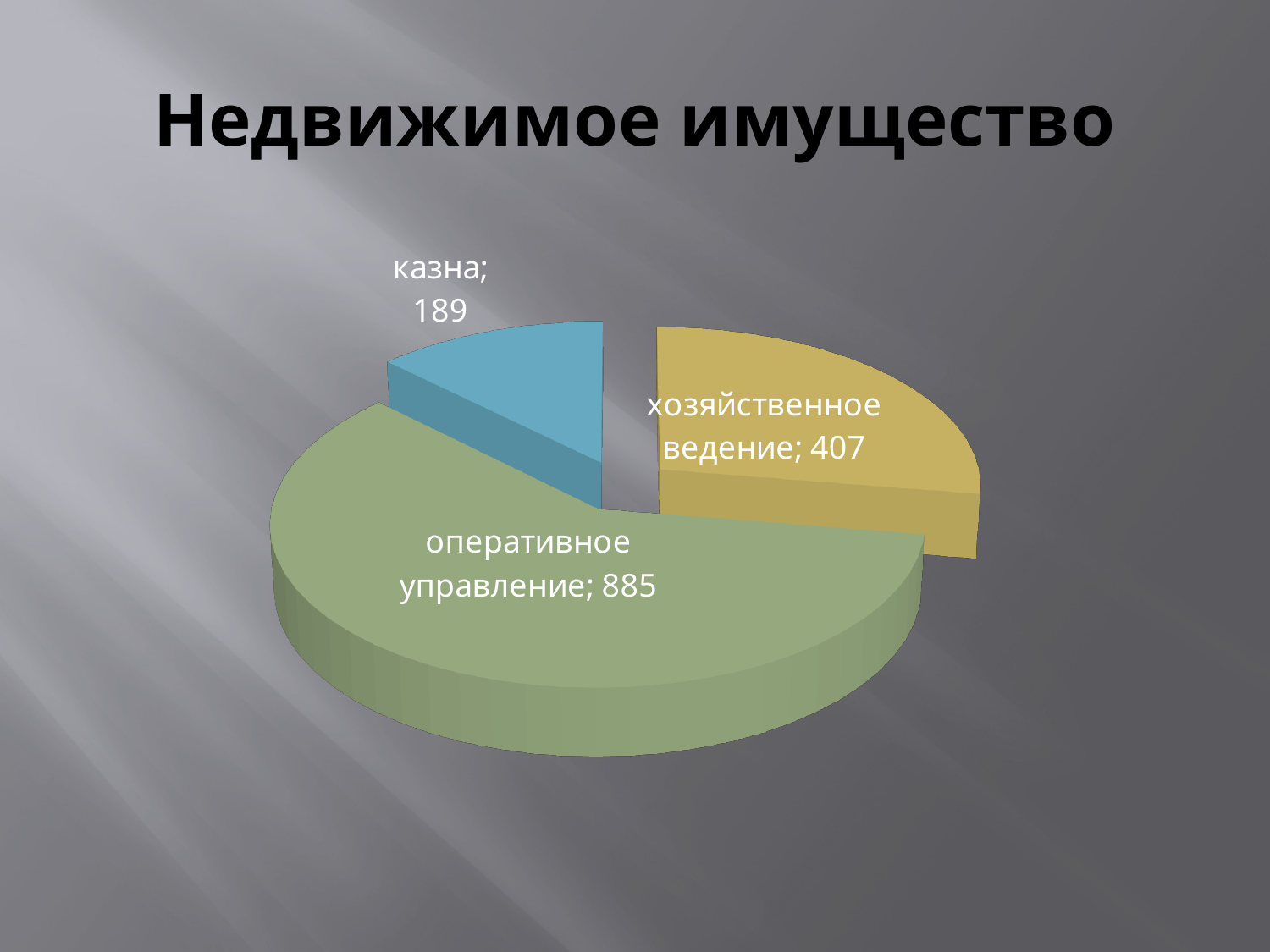
What kind of chart is shown on the slide? pie chart Which category has the smallest slice? казна What is the difference between хозяйственное ведение and казна? 218 What is the title of the slide? Недвижимое имущество What is the value for хозяйственное ведение? 407 Which category has the largest slice? оперативное управление What is the total of all three slices? 1481 What is the difference between оперативное управление and хозяйственное ведение? 478 What is the value for оперативное управление? 885 What is the value for казна? 189 Which is larger, хозяйственное ведение or казна? хозяйственное ведение How many slices does the pie chart have? 3